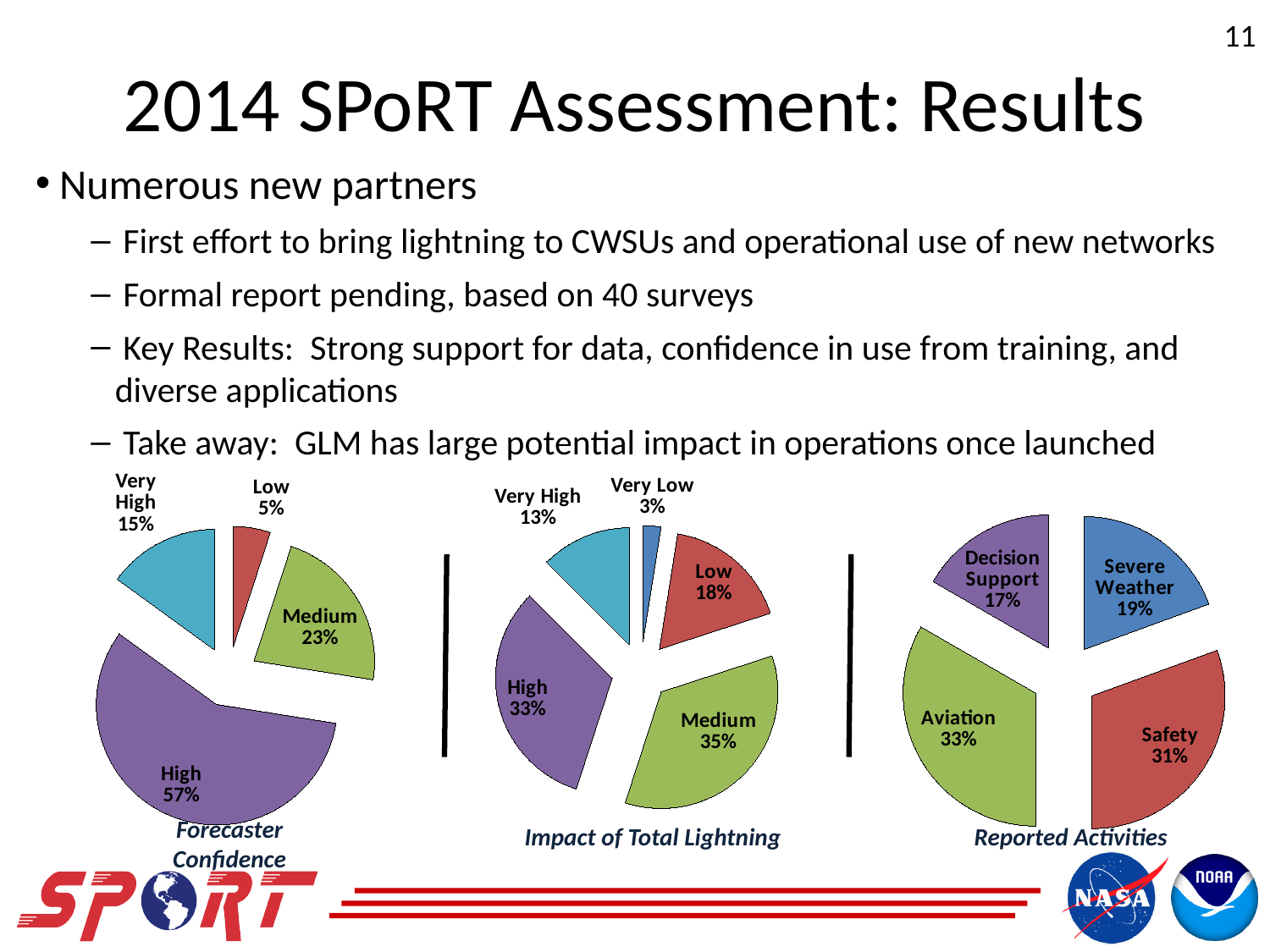
In the Impact of Total Lightning pie chart, which category has the largest share? Medium In the Impact of Total Lightning pie chart, how many categories are shown? 5 In the Forecaster Confidence pie chart, how many slices are there? 4 In the Forecaster Confidence pie chart, what percentage is labelled High? 57% In the Reported Activities pie chart, which category has the largest share? Aviation What type of chart is the Reported Activities chart? Pie chart In the Impact of Total Lightning pie chart, what percentage is labelled Very Low? 3% In the Impact of Total Lightning pie chart, which is larger, Low or Very High? Low In the Forecaster Confidence pie chart, which category has the smallest share? Low In the Forecaster Confidence pie chart, what is the difference between the High and Medium shares? 34% In the Reported Activities pie chart, what percentage is labelled Safety? 31% In the Reported Activities pie chart, what is the difference between the Severe Weather and Decision Support shares? 2%